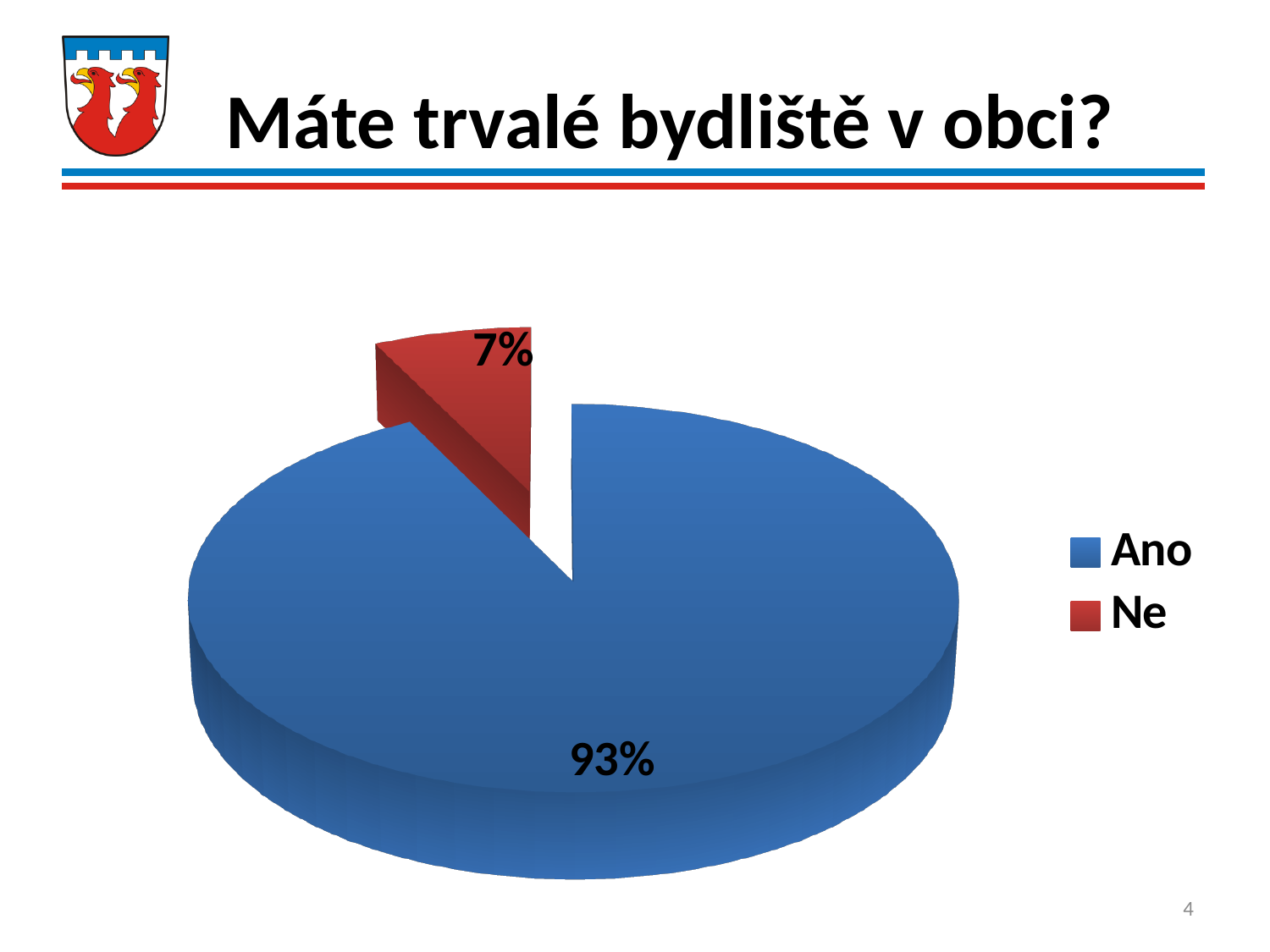
What kind of chart is shown on the slide? pie chart What share of the pie does "Ano" represent? 93% Which is larger, the "Ano" slice or the "Ne" slice? Ano What share of the pie does "Ne" represent? 7% What is the difference in percentage points between the "Ano" and "Ne" slices? 86 Which category has the smallest slice of the pie? Ne What colour is the "Ne" slice in the pie chart? red What is the total of the two slices shown in the pie chart? 100% How many categories are shown in the pie chart? 2 What is the title of the slide containing the chart? Máte trvalé bydliště v obci? Which category has the largest slice of the pie? Ano